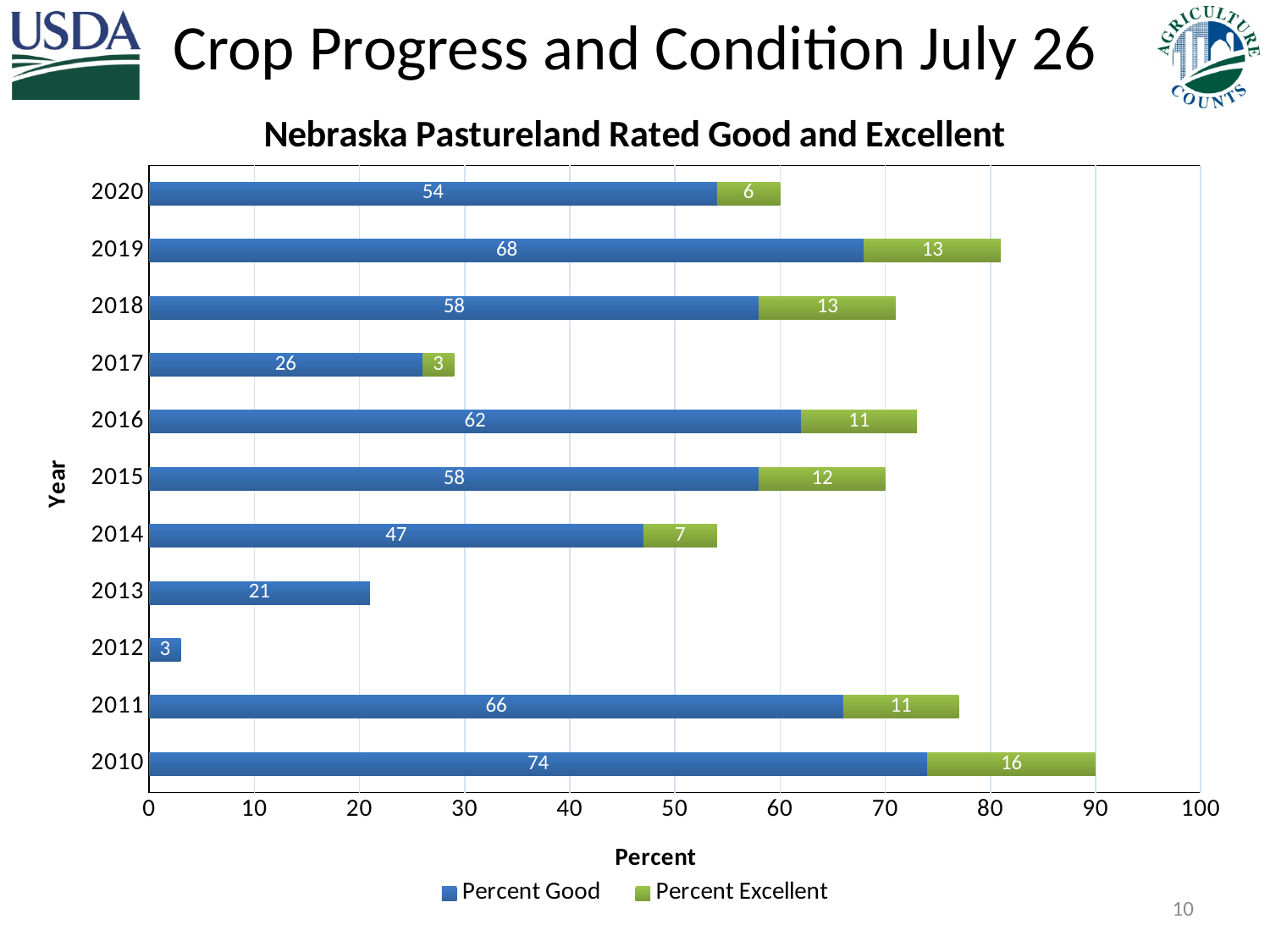
Which is larger, the Percent Excellent value for 2016 or for 2014? 2016 Which year has the lowest Percent Good value? 2012 What is the difference between the Percent Good values for 2019 and 2020? 14 What is the title of the chart? Nebraska Pastureland Rated Good and Excellent How many series does the legend list? 2 What is the Percent Good value for 2019? 68 What is the total of the stacked bar for 2017? 29 Which year has the highest Percent Good value? 2010 What kind of chart is shown on the slide? Stacked bar chart What is the Percent Excellent value for 2010? 16 How many years are shown on the chart? 11 What is the total of the stacked bar for 2010? 90